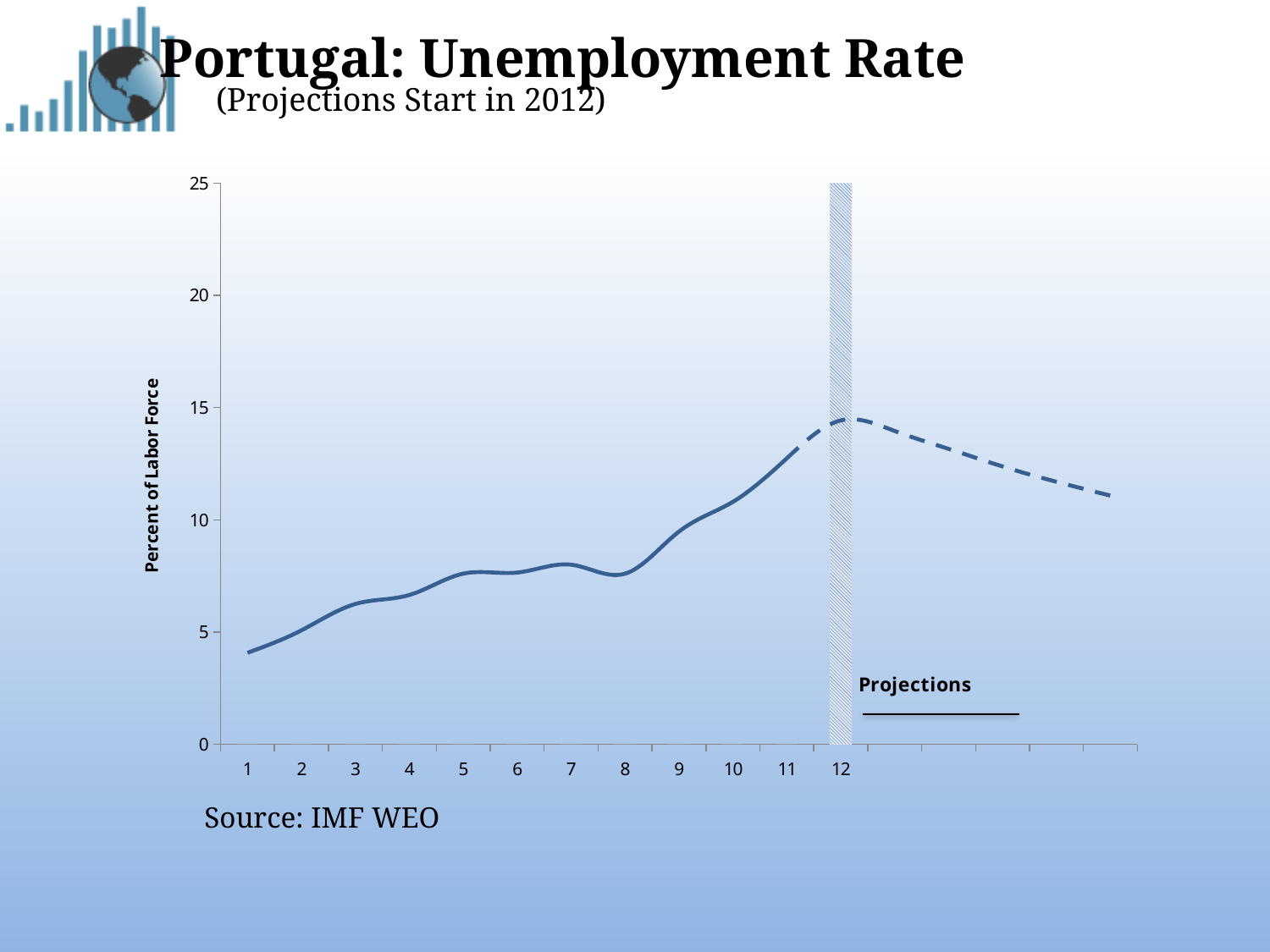
What is the title of the chart on the slide? Portugal: Unemployment Rate What kind of chart is shown on the slide? line chart Is the value at x = 1 greater or less than 5? less What is the label on the vertical axis of the chart? Percent of Labor Force Is the value at x = 3 greater or less than 5? greater Which of the labeled x-axis points has the highest unemployment rate? 12 Is the value at x = 8 greater or less than 10? less Does the unemployment rate generally rise or fall from x = 1 to x = 12? rise Which is larger, the value at x = 12 or the value at x = 1? x = 12 Which of the labeled x-axis points has the lowest unemployment rate? 1